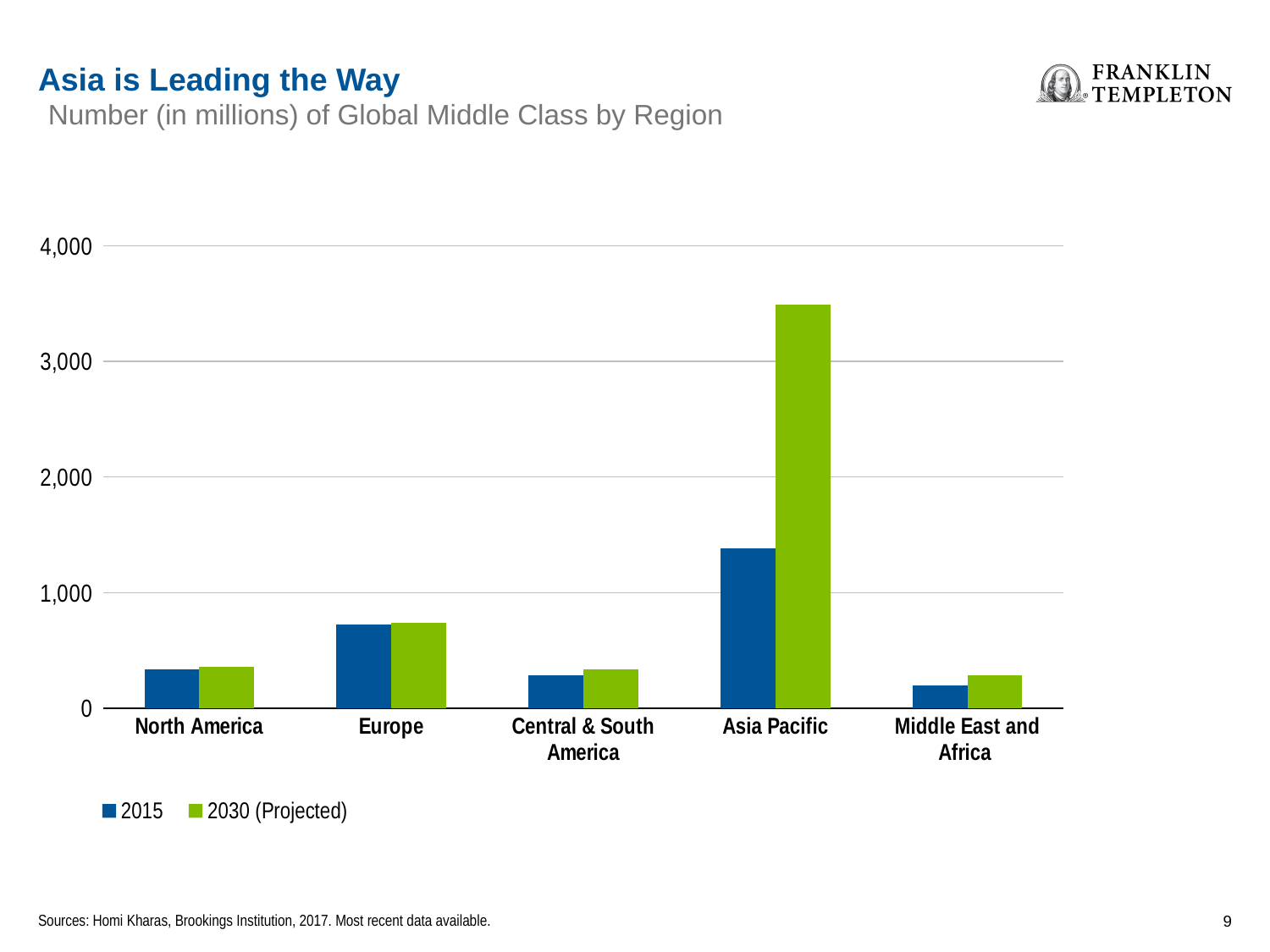
What kind of chart is shown on the slide? bar chart Which is larger: the 2030 (Projected) value for Asia Pacific or the 2030 (Projected) value for Europe? Asia Pacific How many series does the chart's legend list? 2 What are the two series named in the chart's legend? 2015 and 2030 (Projected) How many regions are shown on the x axis of the chart? 5 Which is larger: the 2015 value for Europe or the 2015 value for North America? Europe Which region has the highest value for 2015? Asia Pacific Which region has the highest value for 2030 (Projected)? Asia Pacific Which region has the lowest value for 2015? Middle East and Africa Is the 2030 (Projected) value for Asia Pacific greater or less than 3,000? greater Is the 2015 value for Asia Pacific greater or less than 1,000? greater Is the 2015 value for Europe greater or less than 1,000? less